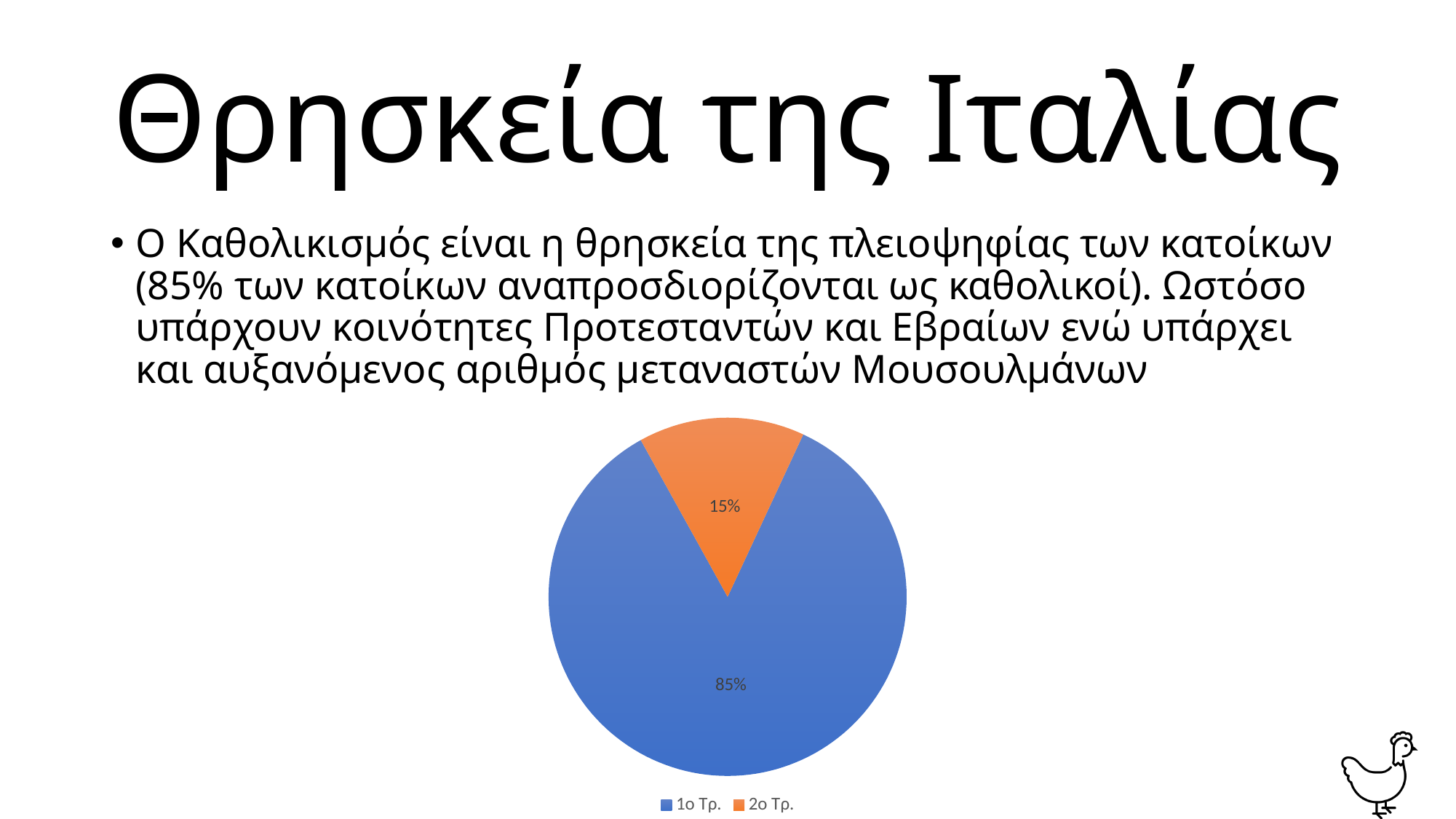
Which slice of the pie chart is the largest? 1ο Τρ. What colour is the "2ο Τρ." slice in the pie chart? orange How many slices does the pie chart have? 2 What is the value of the slice labelled "2ο Τρ." in the pie chart? 15% What share of the pie does the "2ο Τρ." slice represent? 15% Which slice of the pie chart is the smallest? 2ο Τρ. Which is larger in the pie chart, "1ο Τρ." or "2ο Τρ."? 1ο Τρ. What is the value of the slice labelled "1ο Τρ." in the pie chart? 85% What colour is the "1ο Τρ." slice in the pie chart? blue What kind of chart is shown on the slide? pie chart How many entries does the legend of the pie chart list? 2 What is the difference between the "1ο Τρ." slice and the "2ο Τρ." slice? 70%